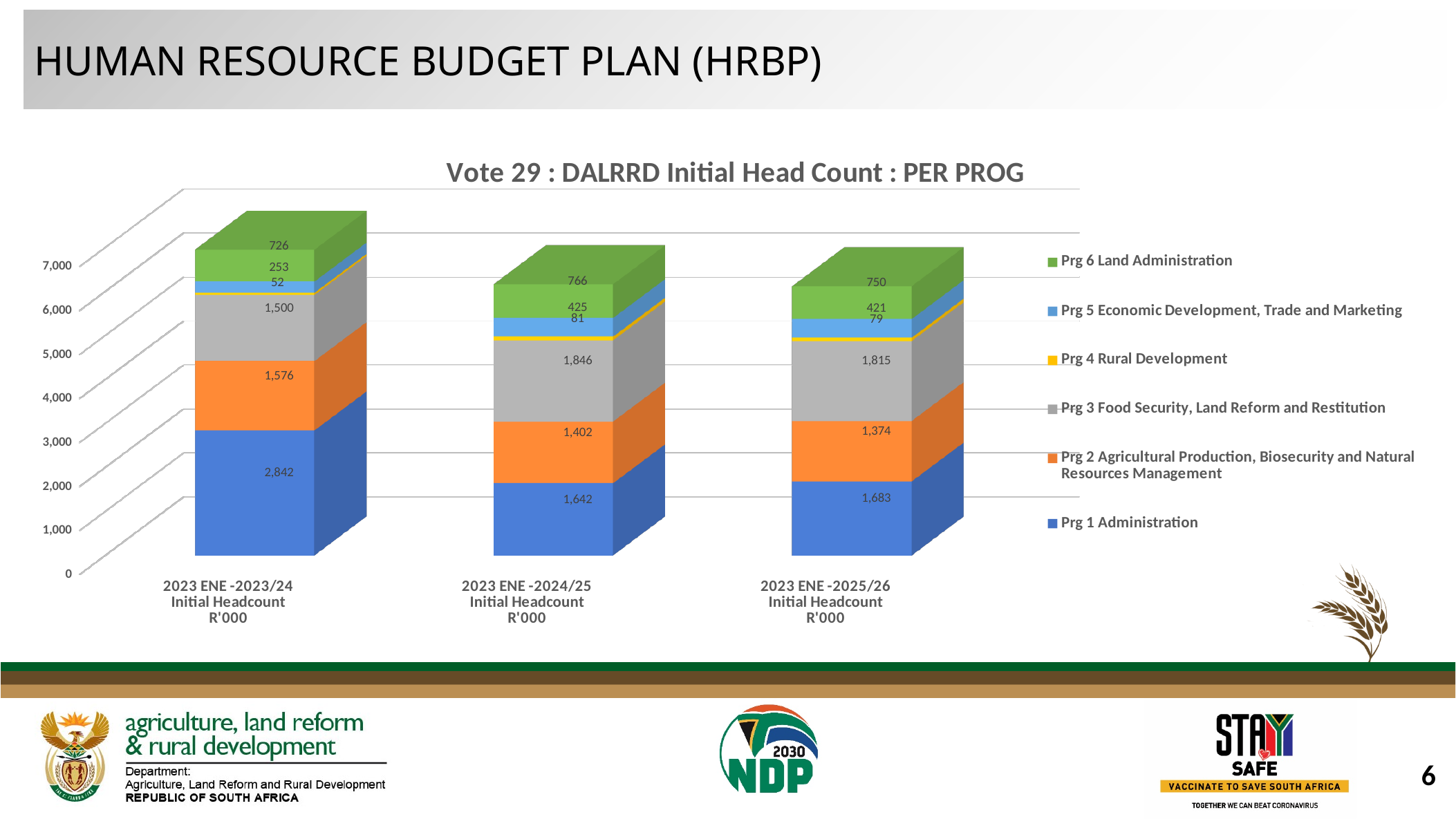
How many series does the legend list? 6 What kind of chart is shown on the slide? Stacked bar chart What is the difference between the Prg 1 Administration values for 2023 ENE -2023/24 and 2023 ENE -2024/25? 1,200 In which year is the value for Prg 1 Administration the highest? 2023 ENE -2023/24 How many bars (financial years) are plotted in the chart? 3 What is the value for Prg 3 Food Security, Land Reform and Restitution in the 2023 ENE -2024/25 Initial Headcount bar? 1,846 What is the value for Prg 6 Land Administration in the 2023 ENE -2023/24 Initial Headcount bar? 726 What is the title of the chart? Vote 29 : DALRRD Initial Head Count : PER PROG Does the value for Prg 2 Agricultural Production, Biosecurity and Natural Resources Management rise or fall from 2023/24 to 2025/26? Fall What is the value for Prg 2 Agricultural Production, Biosecurity and Natural Resources Management in the 2023 ENE -2025/26 Initial Headcount bar? 1,374 Which is larger for Prg 3 Food Security, Land Reform and Restitution: the 2023 ENE -2024/25 value or the 2023 ENE -2025/26 value? 2023 ENE -2024/25 What is the value for Prg 1 Administration in the 2023 ENE -2023/24 Initial Headcount bar? 2,842